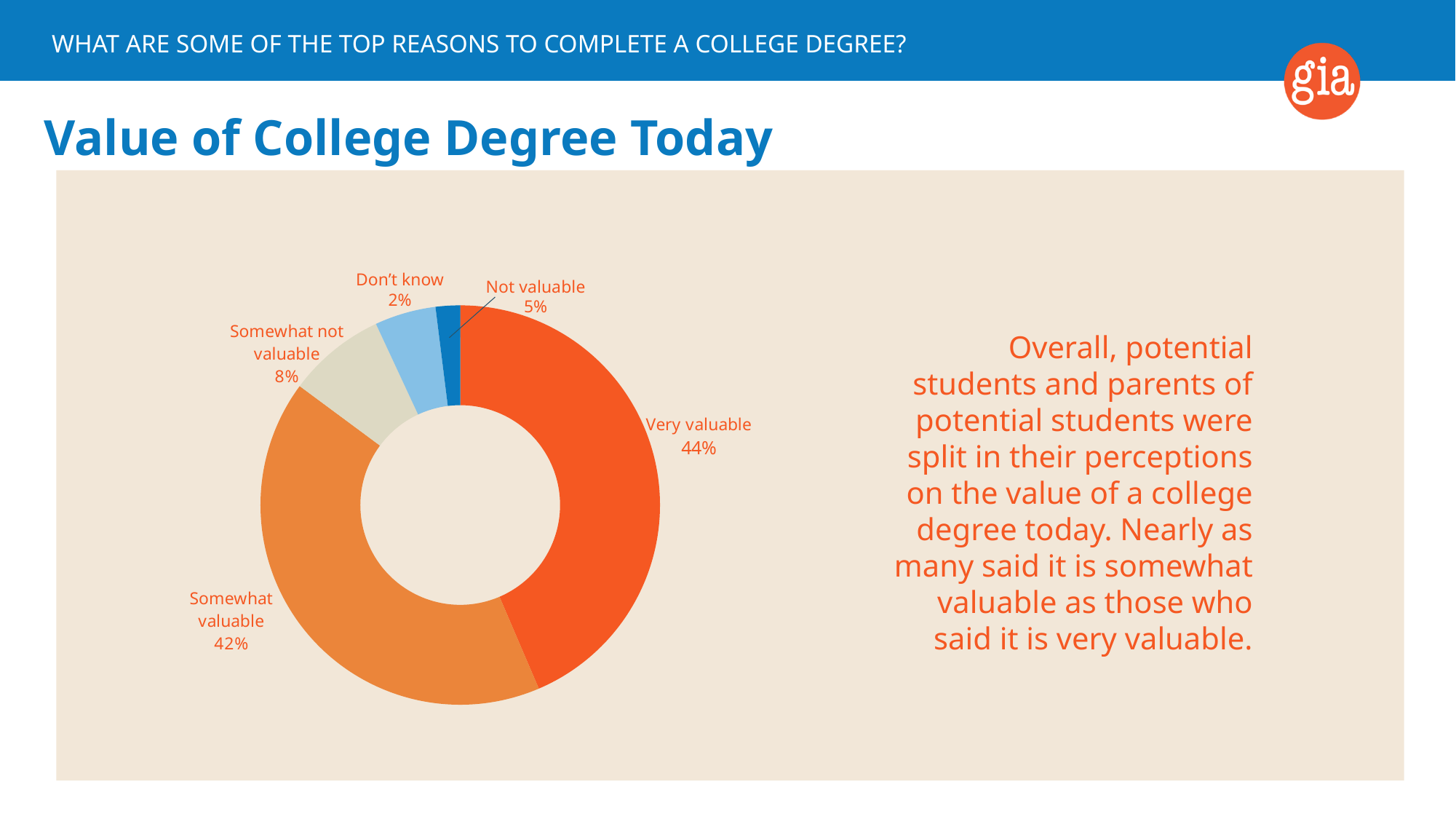
How many categories are shown in the chart? 5 Which category has the smallest share of the chart? Don't know What percentage of respondents said a college degree is very valuable? 44% What percentage of respondents said a college degree is somewhat valuable? 42% What is the title of the chart on the slide? Value of College Degree Today Which category has the largest share of the chart? Very valuable What percentage of respondents answered 'Don't know'? 2% What percentage of respondents said a college degree is not valuable? 5% What is the difference in percentage points between 'Very valuable' and 'Somewhat valuable'? 2 Which is larger, the share for 'Somewhat not valuable' or the share for 'Not valuable'? Somewhat not valuable What kind of chart is shown on the slide? Pie chart (doughnut) What percentage of respondents said a college degree is somewhat not valuable? 8%